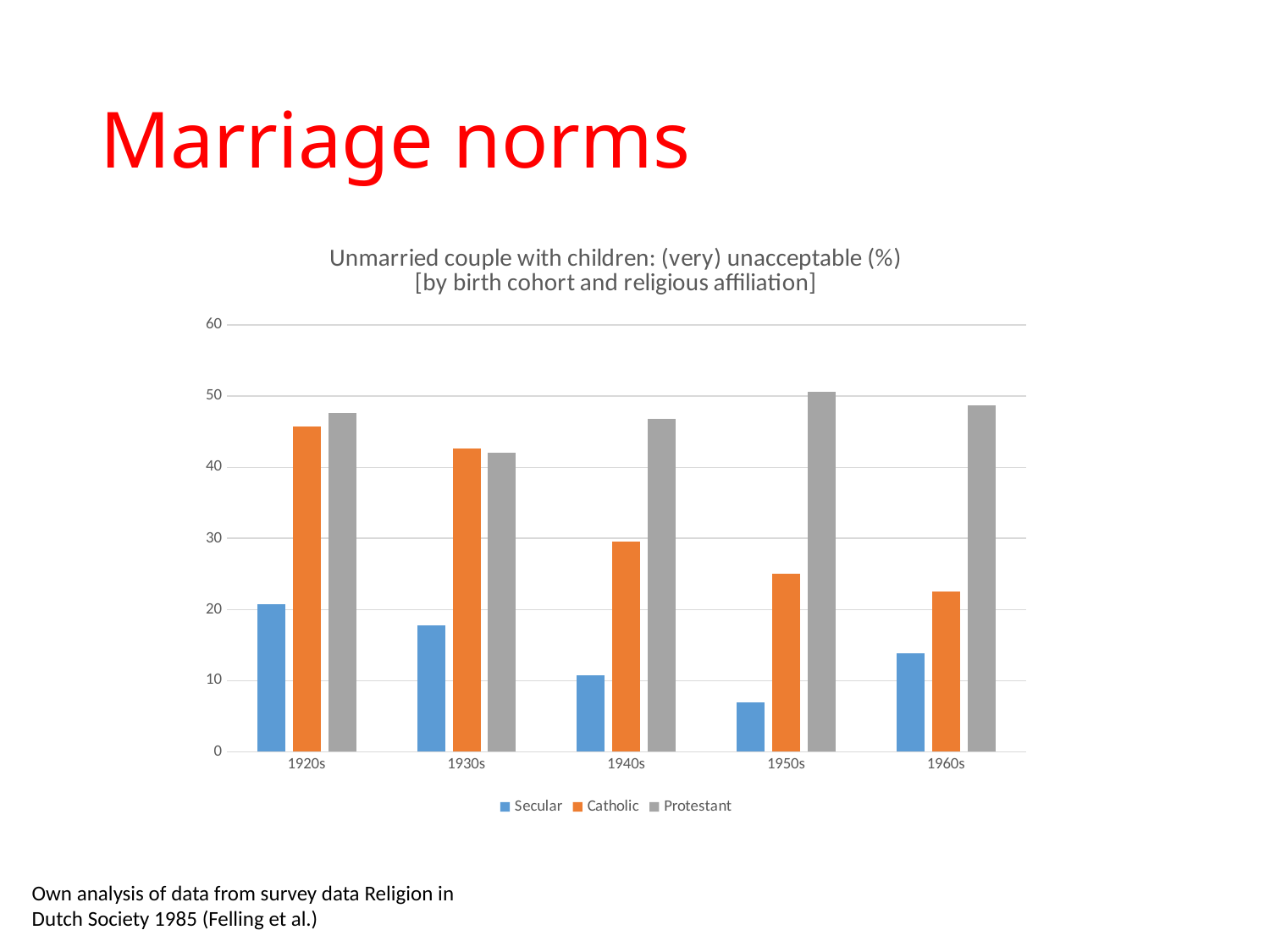
Which birth cohort has the highest Catholic value? 1920s How many birth cohorts are shown on the x axis? 5 Which colour represents the Protestant series in the legend? Grey Which birth cohort has the highest Protestant value? 1950s For the 1940s cohort, which is larger: the Catholic value or the Protestant value? Protestant Do the Catholic values rise or fall from the 1920s to the 1960s cohort? Fall Which birth cohort has the lowest Secular value? 1950s Is the Secular value for the 1950s cohort greater or less than 10? less Is the Protestant value for the 1920s cohort greater or less than 50? less Is the Catholic value for the 1950s cohort greater or less than 20? greater What kind of chart is shown on the slide? Bar chart How many series does the legend list? 3